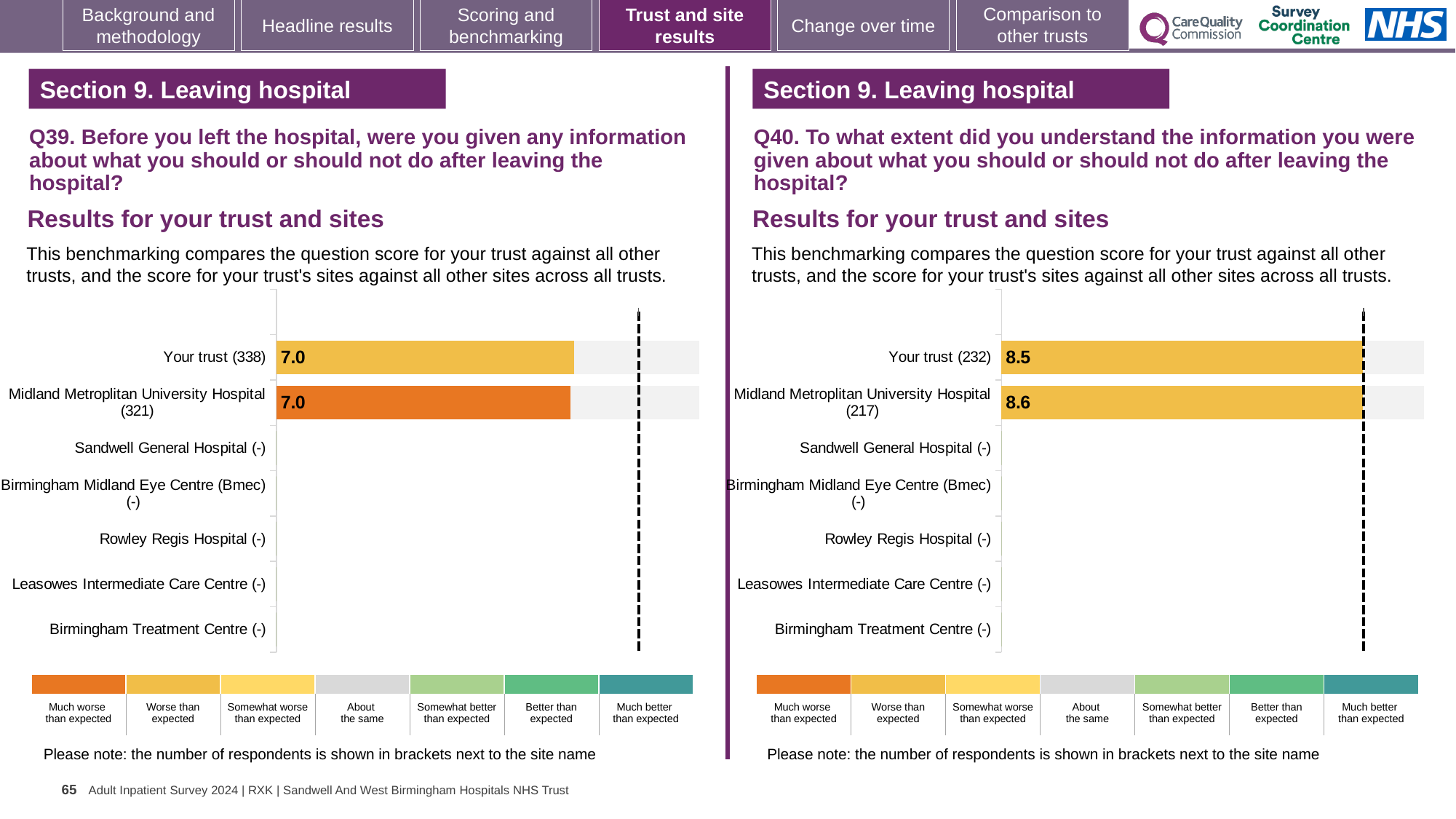
In the Q40 chart on the right, what is the score for Midland Metropolitan University Hospital (217)? 8.6 In the Q39 chart on the left, what is the score for Midland Metropolitan University Hospital (321)? 7.0 In the Q40 chart on the right, what is the score for Your trust (232)? 8.5 How many site/trust categories are listed on the y axis of the Q40 chart on the right? 7 In the Q39 chart on the left, what is the score for Your trust (338)? 7.0 In the Q39 chart on the left, what benchmark category does the colour of the Midland Metropolitan University Hospital (321) bar correspond to? Much worse than expected In the Q39 chart on the left, how many categories have a plotted bar? 2 In the Q40 chart on the right, what is the difference between the score for Midland Metropolitan University Hospital (217) and the score for Your trust (232)? 0.1 What kind of chart is the Q39 chart on the left? Bar chart How many respondents are shown in brackets for Your trust in the Q40 chart on the right? 232 In the Q39 chart on the left, what is the difference between the score for Your trust (338) and the score for Midland Metropolitan University Hospital (321)? 0.0 In the Q40 chart on the right, which has the higher score: Your trust (232) or Midland Metropolitan University Hospital (217)? Midland Metropolitan University Hospital (217)